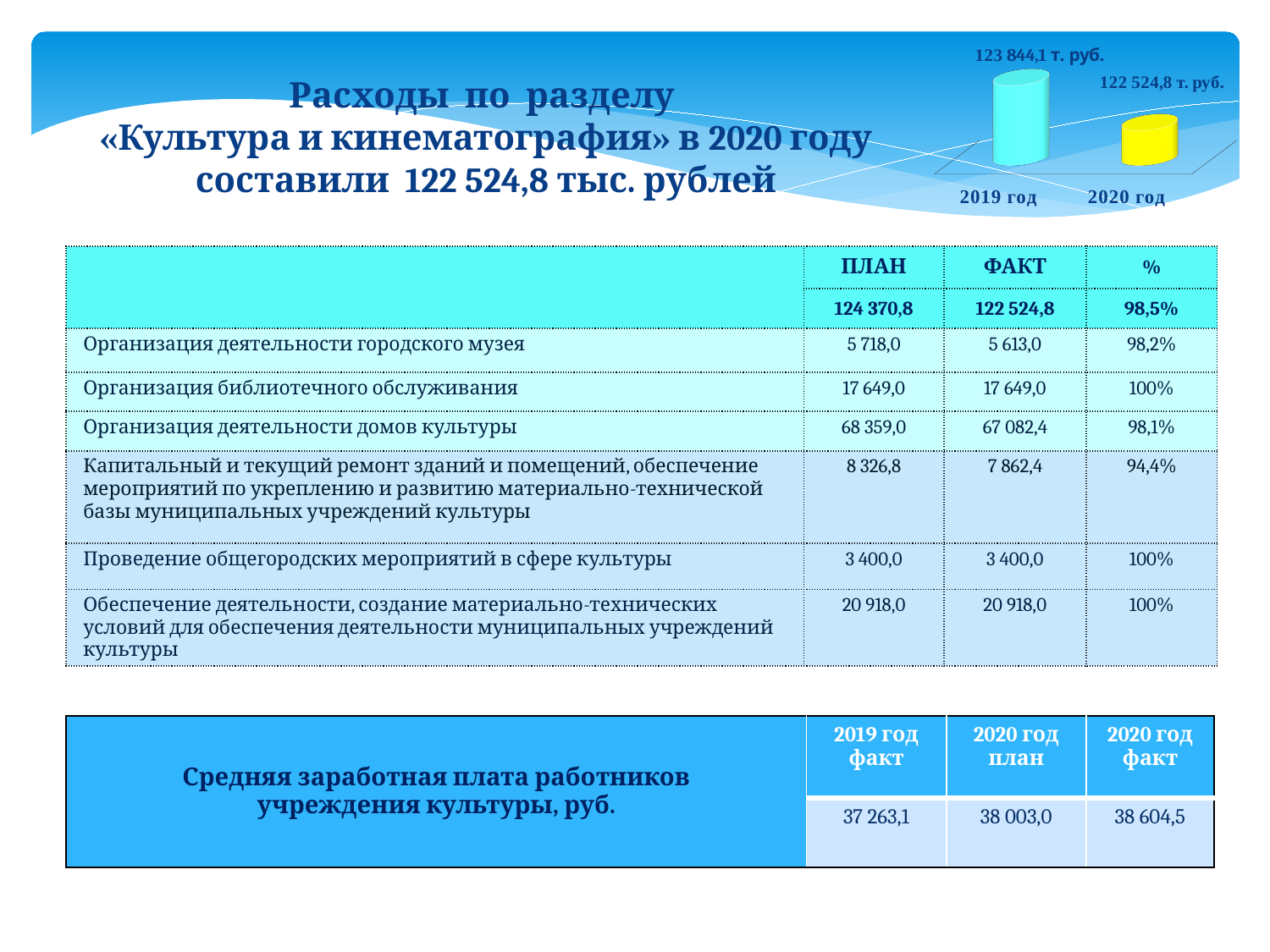
How many categories (years) are plotted in the chart? 2 Which year has the higher value in the chart? 2019 год By how much does the 2019 год value exceed the 2020 год value in the chart? 1 319,3 т. руб. What colour is the bar for 2020 год in the chart? yellow Is the value for 2019 год larger or smaller than the value for 2020 год in the chart? larger What colour is the bar for 2019 год in the chart? light blue Do the values in the chart rise or fall from 2019 год to 2020 год? fall Which year has the lower value in the chart? 2020 год What kind of chart is shown in the top right of the slide? bar chart What is the value shown for 2020 год in the chart? 122 524,8 т. руб. What is the value shown for 2019 год in the chart? 123 844,1 т. руб.